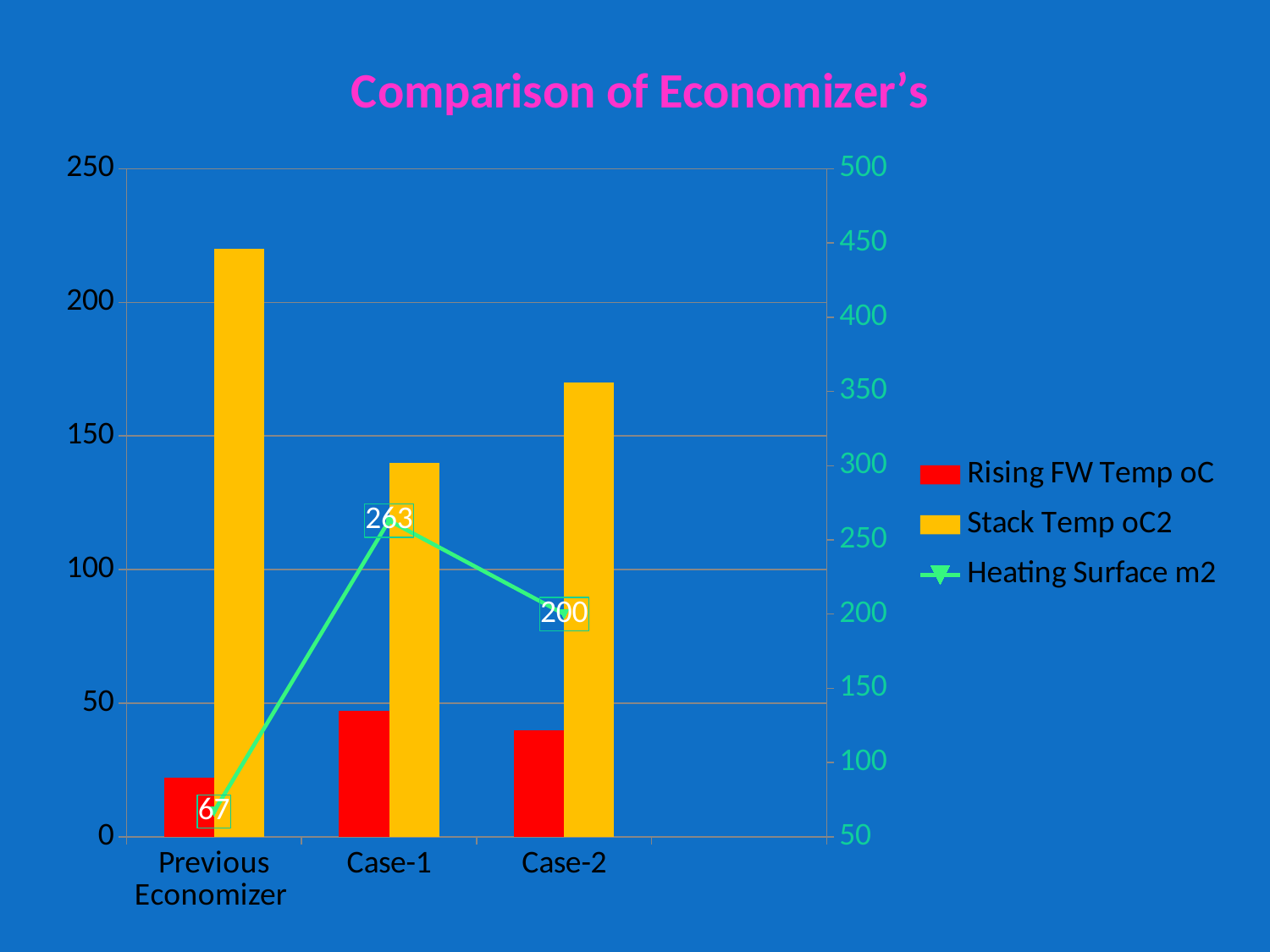
Which category has the lowest Heating Surface m2 value? Previous Economizer What is the Heating Surface m2 value for Previous Economizer? 67 What is the Heating Surface m2 value for Case-1? 263 What is the Heating Surface m2 value for Case-2? 200 What is the title of the chart? Comparison of Economizer's What is the difference between the Heating Surface m2 values for Case-1 and Case-2? 63 Is the Rising FW Temp oC value for Case-1 greater or less than 50? less Which category has the highest Heating Surface m2 value? Case-1 How many categories are shown on the x axis? 3 How many series does the legend list? 3 Which has a larger Stack Temp oC2 value, Previous Economizer or Case-2? Previous Economizer Is the Stack Temp oC2 value for Previous Economizer greater or less than 200? greater